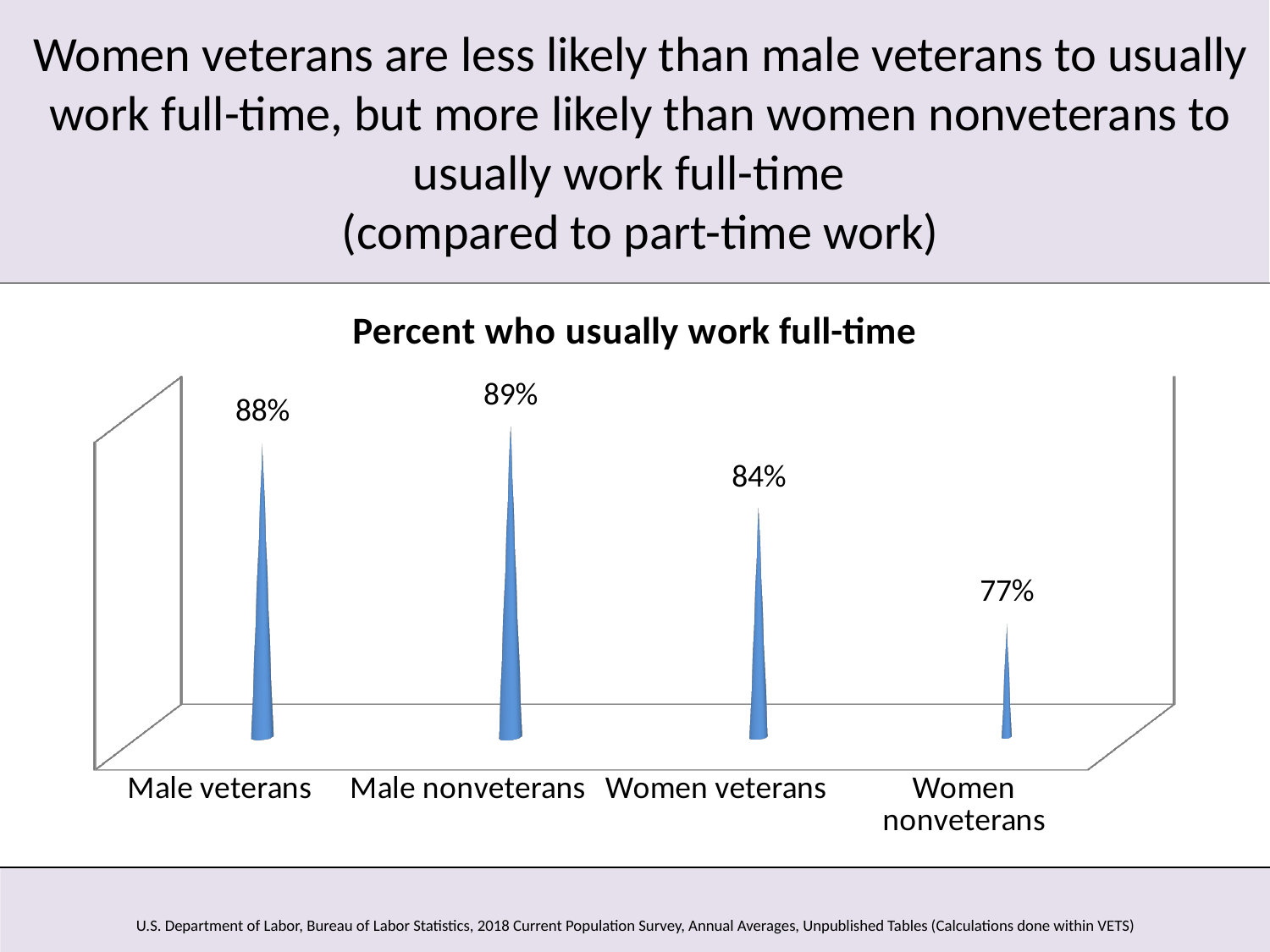
What is the percent who usually work full-time for Male nonveterans? 89% What is the percent who usually work full-time for Male veterans? 88% What is the difference in percentage points between Women veterans and Women nonveterans? 7 What is the title of the chart? Percent who usually work full-time What is the percent who usually work full-time for Women veterans? 84% What kind of chart is shown on the slide? Bar chart What is the difference in percentage points between Male veterans and Women veterans? 4 Which is larger, the value for Women veterans or the value for Women nonveterans? Women veterans Which category has the highest percent who usually work full-time? Male nonveterans What is the percent who usually work full-time for Women nonveterans? 77% How many categories are shown in the chart? 4 Which category has the lowest percent who usually work full-time? Women nonveterans